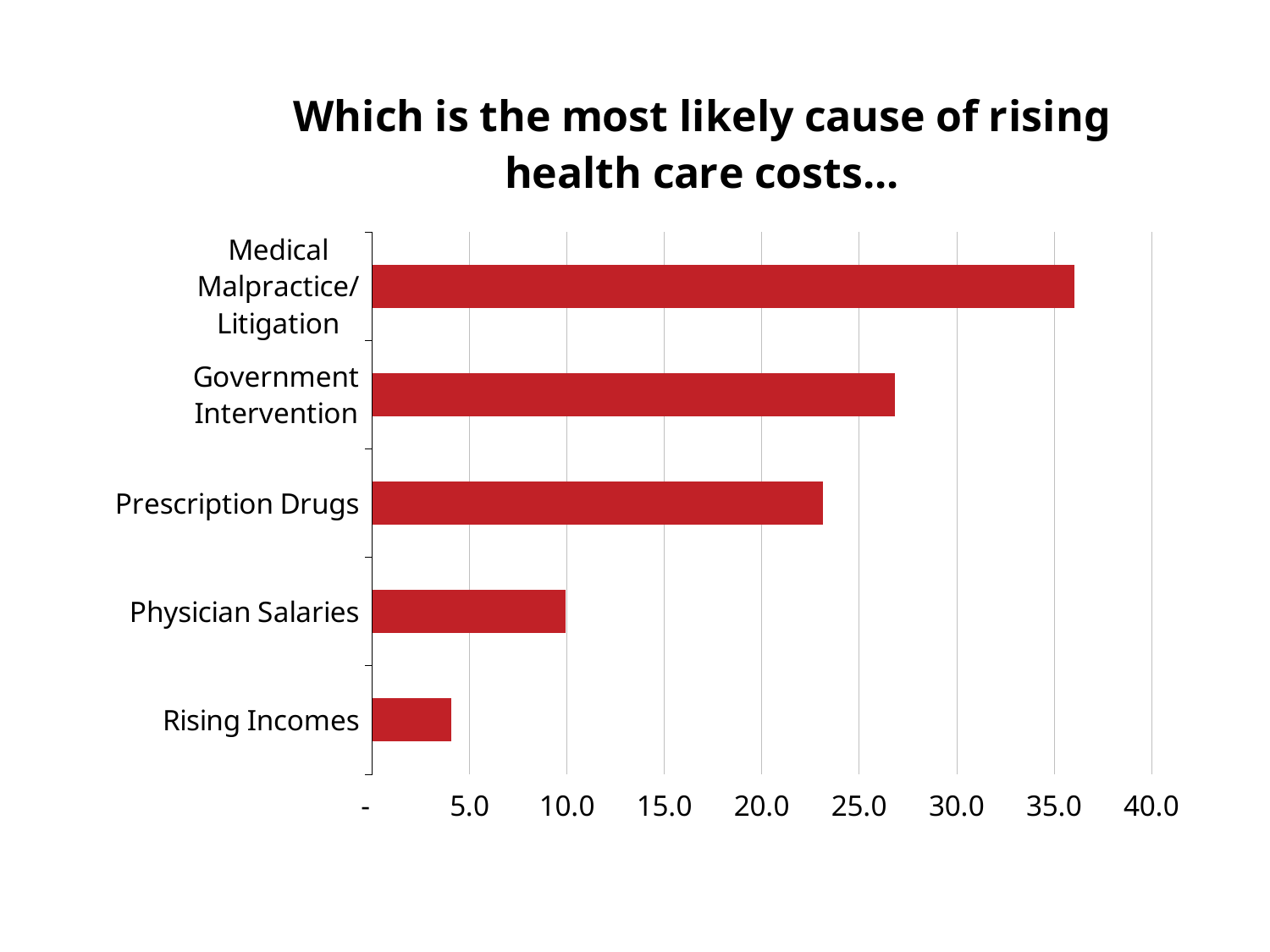
Which has a larger value, Government Intervention or Prescription Drugs? Government Intervention Which category has the lowest value? Rising Incomes What is the title of the chart? Which is the most likely cause of rising health care costs... What is the maximum value shown on the horizontal axis? 40.0 Is the value for Rising Incomes greater or less than 5.0? less Which has a larger value, Physician Salaries or Rising Incomes? Physician Salaries How many categories are shown in the chart? 5 Is the value for Government Intervention greater or less than 25.0? greater Is the value for Medical Malpractice/Litigation greater or less than 35.0? greater What type of chart is shown on the slide? bar chart Which category has the highest value? Medical Malpractice/Litigation